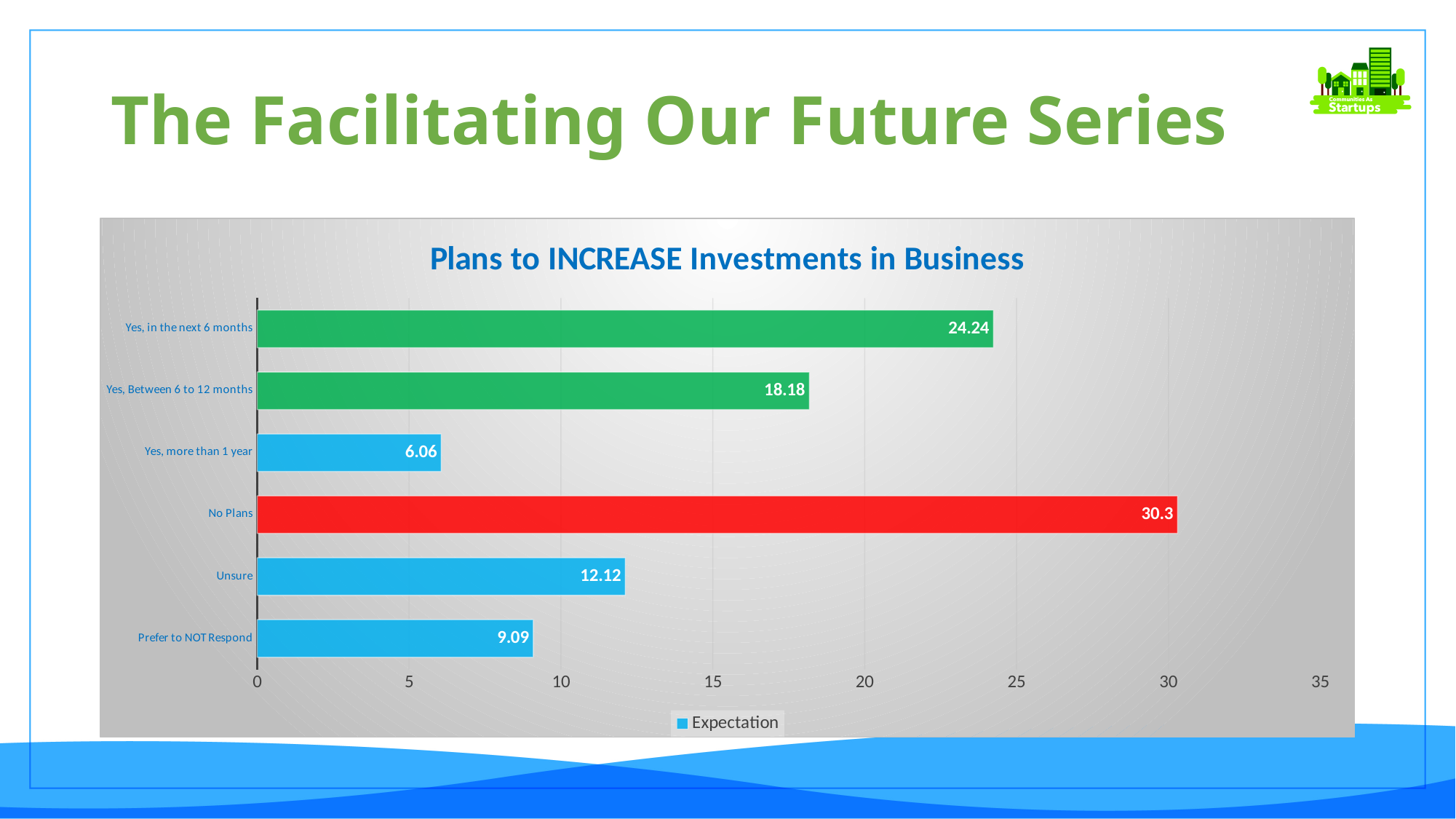
What is the value for "No Plans"? 30.3 What is the difference between the values for "Yes, in the next 6 months" and "Yes, Between 6 to 12 months"? 6.06 How many categories are shown in the chart? 6 What is the value for "Prefer to NOT Respond"? 9.09 Which category has the lowest value? Yes, more than 1 year What is the value for "Yes, more than 1 year"? 6.06 Which category has the highest value? No Plans What is the value for "Yes, in the next 6 months"? 24.24 What is the title of the chart? Plans to INCREASE Investments in Business Is the value for "Yes, Between 6 to 12 months" greater or less than 20? less Which is larger, the value for "Unsure" or the value for "Prefer to NOT Respond"? Unsure What kind of chart is shown on the slide? bar chart